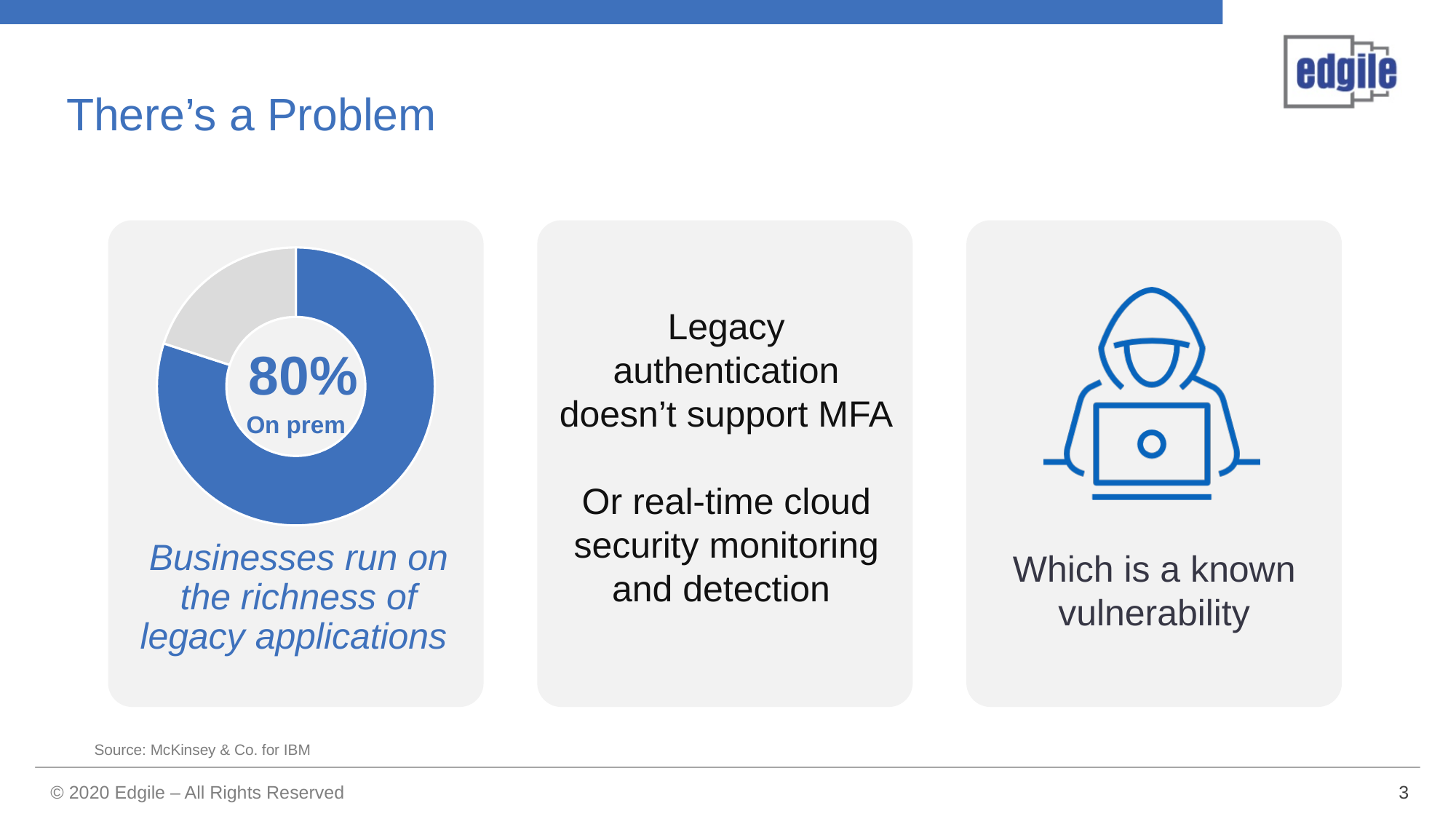
Is the On prem share in the donut chart greater or less than 50%? greater What source is cited for the donut chart data? McKinsey & Co. for IBM What kind of chart is shown on the slide? Donut chart What percentage is shown in the centre of the donut chart? 80% What share of the donut chart does the On prem segment represent? 80% What colour is the On prem segment of the donut chart? Blue How many segments does the donut chart have? 2 Which segment of the donut chart is larger, the blue one or the grey one? The blue one What label appears beneath the 80% value in the donut chart? On prem